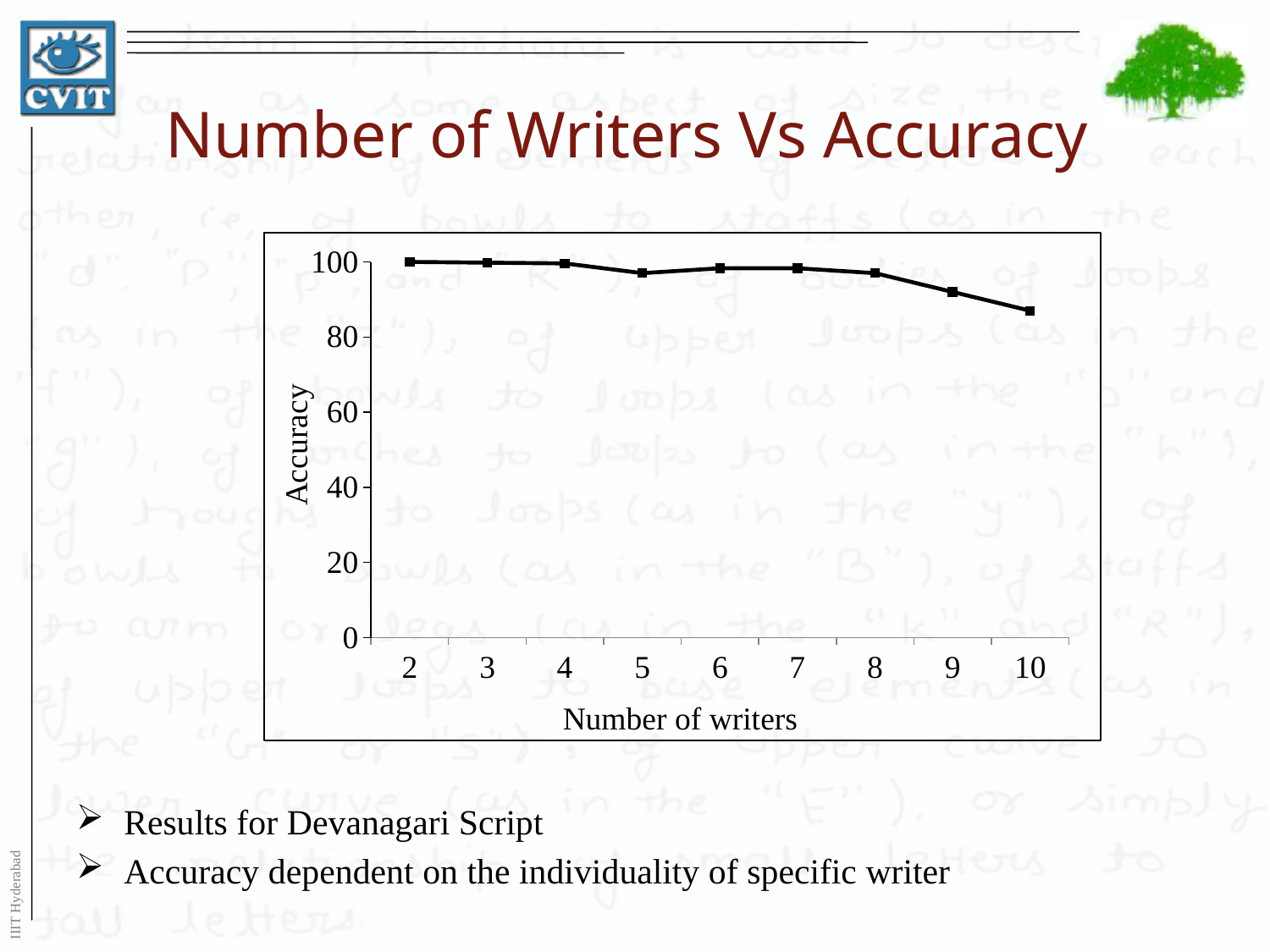
How many data points are plotted on the line? 9 Is the accuracy for 10 writers greater or less than 80? greater Which has the higher accuracy, 2 writers or 10 writers? 2 writers What is the label of the x axis? Number of writers Which has the higher accuracy, 9 writers or 10 writers? 9 writers Does accuracy generally rise or fall as the number of writers increases? fall Is the accuracy for 9 writers greater or less than 80? greater Which number of writers has the lowest accuracy? 10 What kind of chart is shown on the slide? line chart What is the title of the chart? Number of Writers Vs Accuracy Is the accuracy for 2 writers greater or less than 60? greater